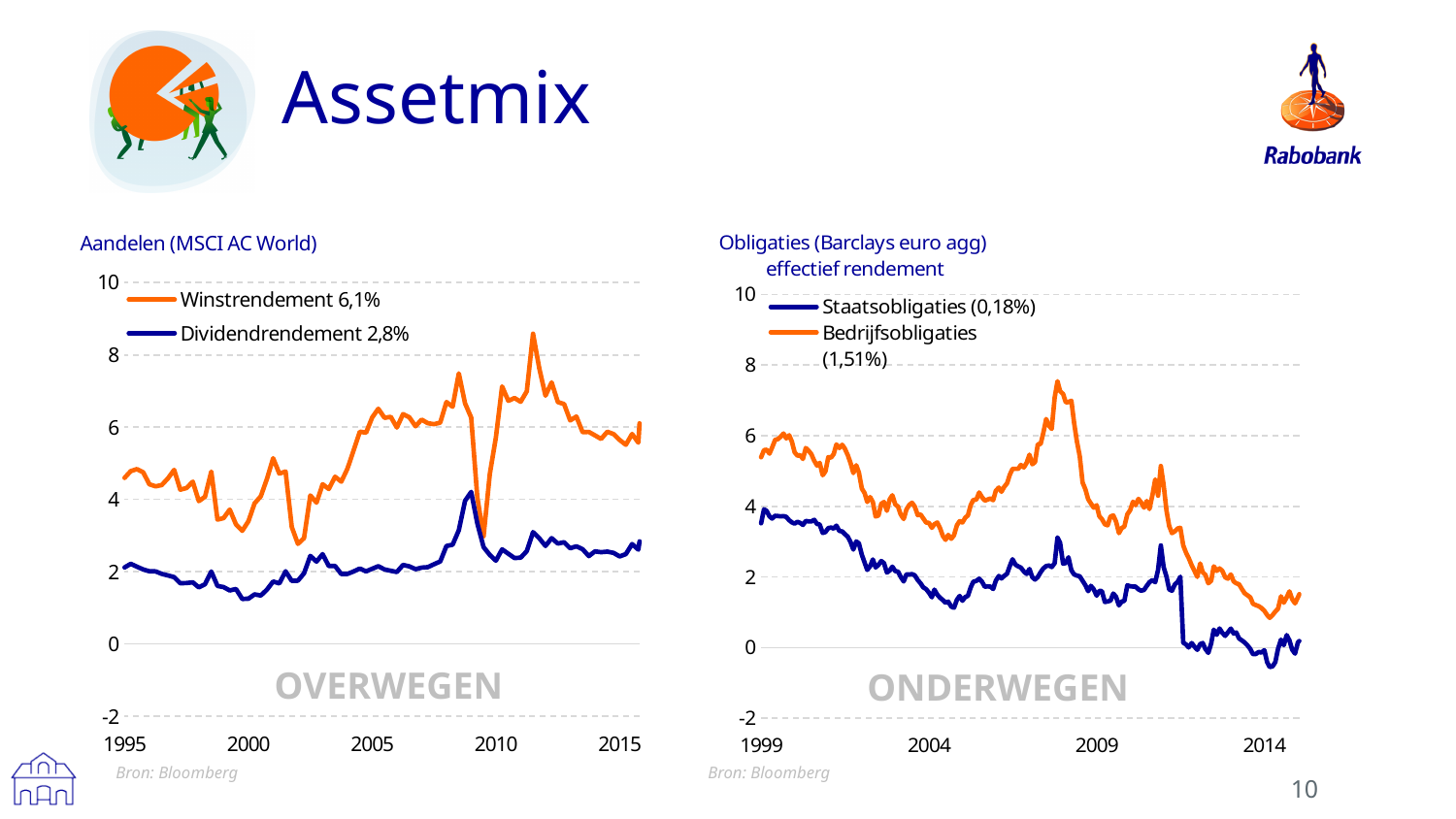
On the Obligaties (Barclays euro agg) chart, what is the Staatsobligaties value given in the legend? 0,18% On the Aandelen (MSCI AC World) chart, is the peak of the Winstrendement line around 2011 greater or less than 8? greater On the Obligaties (Barclays euro agg) chart, does the Staatsobligaties line overall rise or fall from 1999 to 2014? Fall On the Aandelen (MSCI AC World) chart, what is the Winstrendement value given in the legend? 6,1% On the Aandelen (MSCI AC World) chart, what is the Dividendrendement value given in the legend? 2,8% How many series does the legend of the Obligaties (Barclays euro agg) chart list? 2 On the Obligaties (Barclays euro agg) chart, which legend value is larger, Staatsobligaties or Bedrijfsobligaties? Bedrijfsobligaties What kind of chart is the Aandelen (MSCI AC World) chart? Line chart On the Obligaties (Barclays euro agg) chart, is the Staatsobligaties value in 2014 greater or less than 2? less On the Obligaties (Barclays euro agg) chart, what is the Bedrijfsobligaties value given in the legend? 1,51% What source is cited below both charts? Bloomberg On the Aandelen (MSCI AC World) chart, what is the difference between the Winstrendement and Dividendrendement values shown in the legend? 3,3%